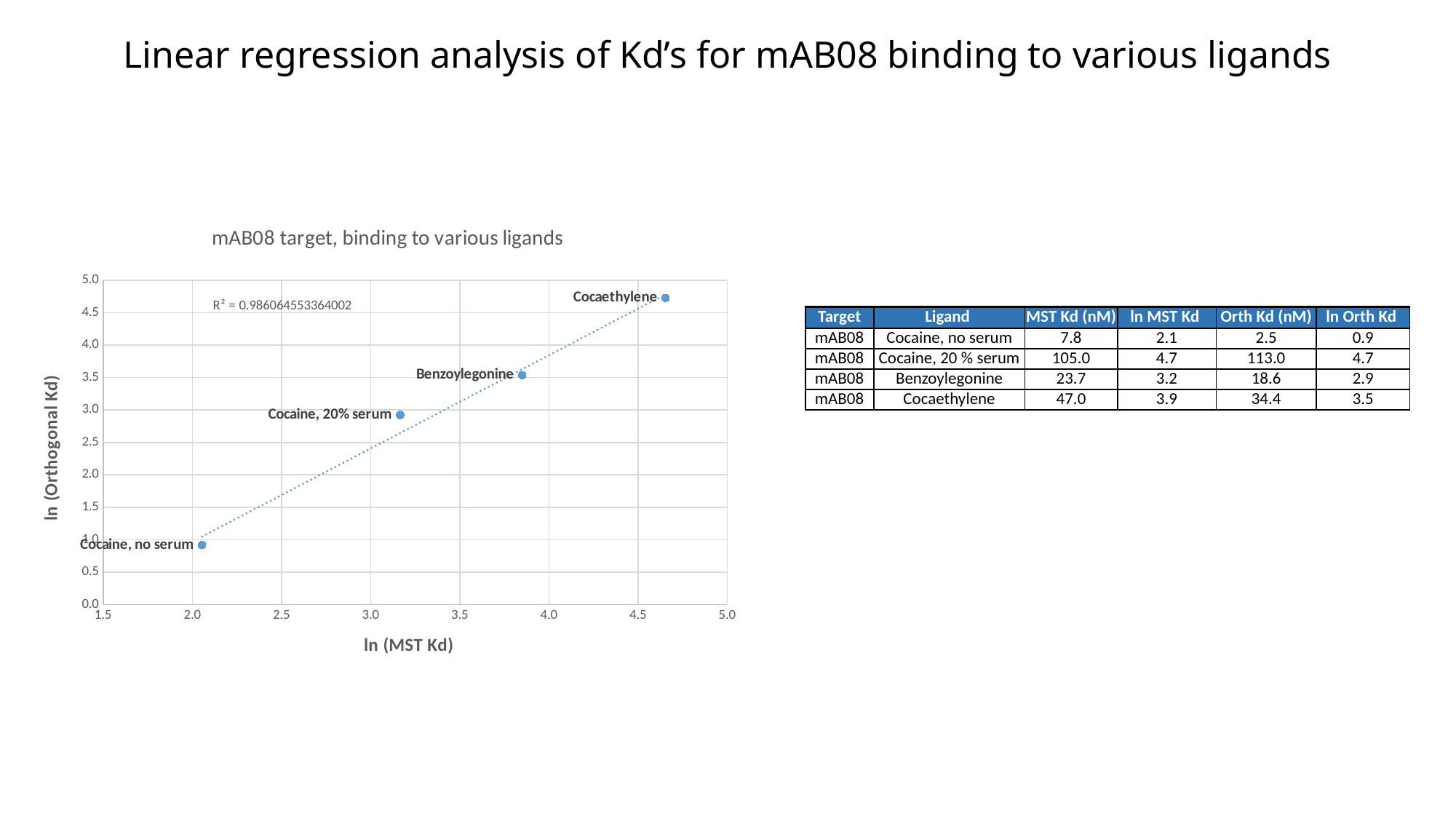
What is the title of the chart? mAB08 target, binding to various ligands What kind of chart is shown on the slide? Scatter chart Is the ln (MST Kd) value for Benzoylegonine greater or less than 4.0? less Which labelled point has the highest ln (Orthogonal Kd) value? Cocaethylene Which labelled point has the lowest ln (Orthogonal Kd) value? Cocaine, no serum Do the ln (Orthogonal Kd) values rise or fall as ln (MST Kd) increases along the x axis? Rise What R² value is shown on the chart? 0.986064553364002 Is the ln (Orthogonal Kd) value for Cocaethylene greater or less than 4.5? greater Which point has a larger ln (Orthogonal Kd) value, Benzoylegonine or Cocaine, 20% serum? Benzoylegonine Is the ln (Orthogonal Kd) value for Cocaine, no serum greater or less than 1.5? less How many data points are plotted in the chart? 4